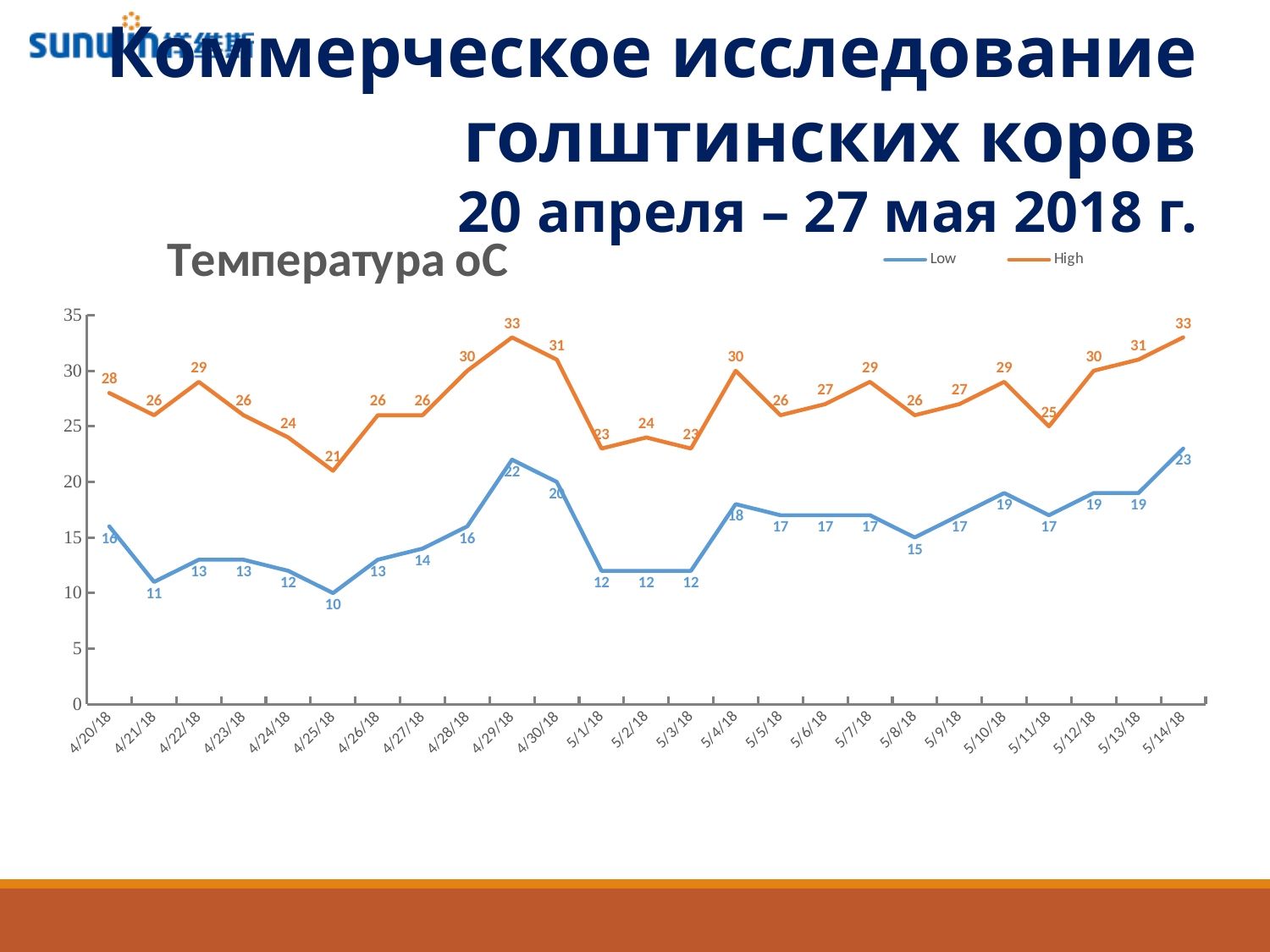
What kind of chart is shown on the slide? line chart On which date is the Low series at its highest? 5/14/18 On which date is the High series at its lowest? 4/25/18 What is the difference between the Low values on 4/29/18 and 4/30/18? 2 What is the Low value on 4/29/18? 22 Which is larger, the Low value on 4/29/18 or the Low value on 5/14/18? 5/14/18 On which date is the Low series at its lowest? 4/25/18 How many series does the legend list? 2 What is the High value on 5/11/18? 25 How many dates are plotted on the x axis? 25 What is the High value on 4/25/18? 21 What is the difference between the High and Low values on 5/14/18? 10